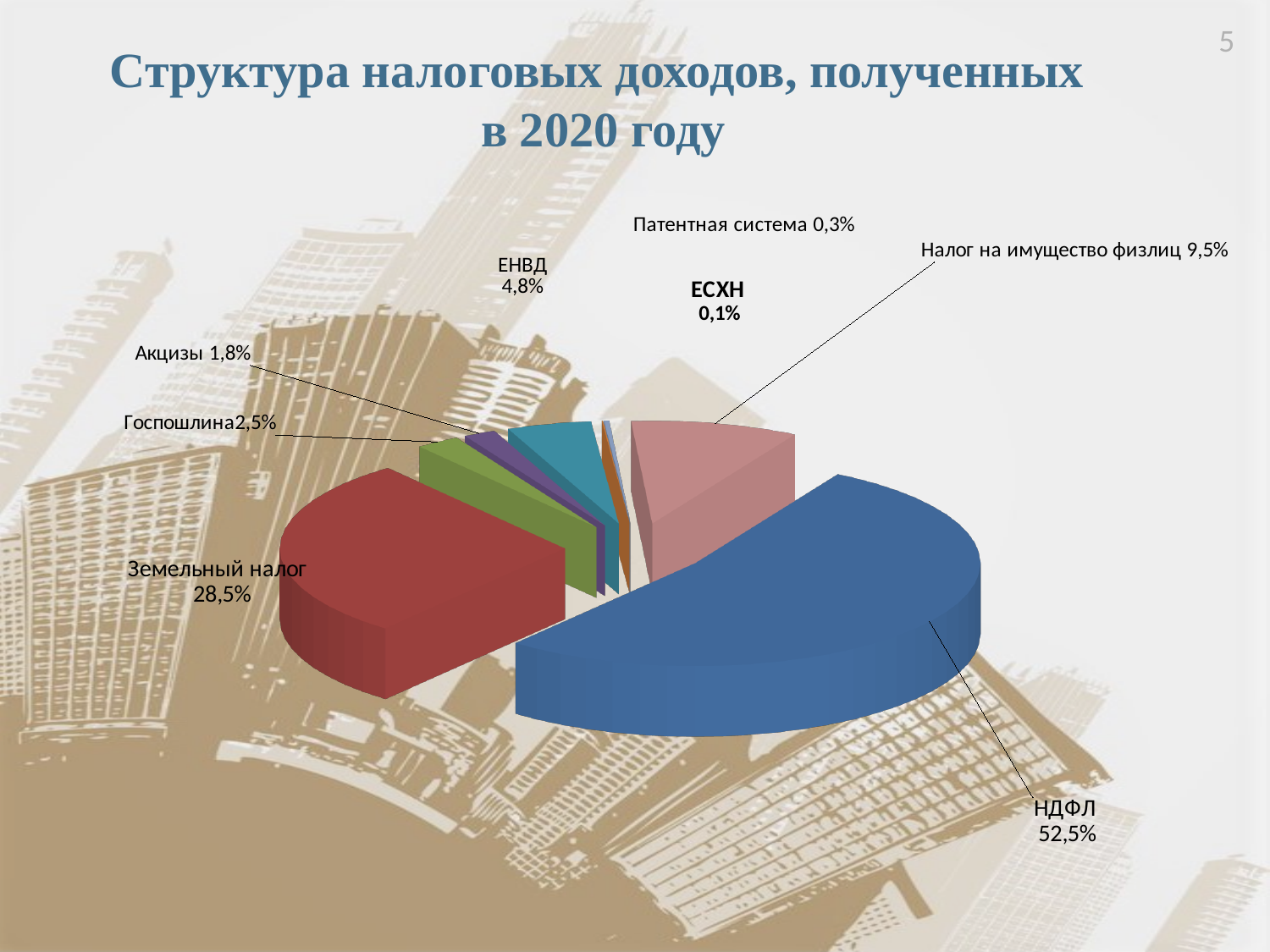
What percentage is shown for Налог на имущество физлиц? 9,5% What is the difference in percentage points between НДФЛ and Земельный налог? 24 percentage points What is the value shown for ЕНВД? 4,8% What share of tax revenue does НДФЛ account for? 52,5% What is the title of the slide? Структура налоговых доходов, полученных в 2020 году Which category has the largest share of tax revenue? НДФЛ Which category has the smallest share in the pie chart? ЕСХН How many categories are shown in the pie chart? 8 Which is larger, the share of Акцизы or the share of Госпошлина? Госпошлина What share is shown for Госпошлина? 2,5% What is the share of Земельный налог in the pie chart? 28,5% What type of chart is shown on the slide? Pie chart